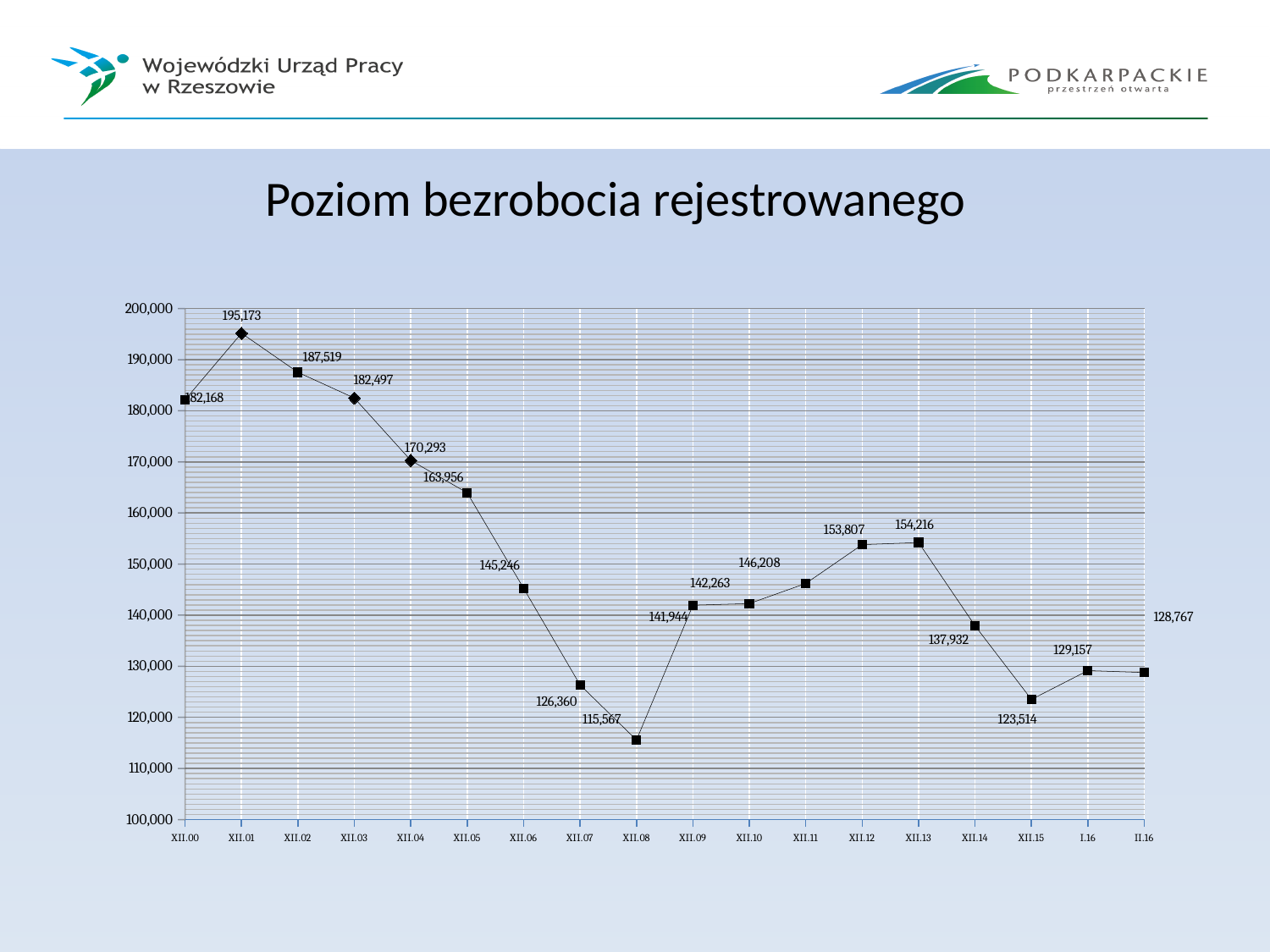
What is the difference between the values for XII.01 and XII.00? 13,005 What type of chart is shown on the slide? line chart Do the values rise or fall from XII.01 to XII.08? fall What is the difference between the values for XII.09 and XII.08? 26,377 What is the value for II.16? 128,767 How many data points are plotted on the chart? 18 Which period has the lowest value? XII.08 What is the value for XII.08? 115,567 What is the title of the chart? Poziom bezrobocia rejestrowanego Which is larger, the value for XII.05 or the value for XII.14? XII.05 Which period has the highest value? XII.01 What is the value for XII.01? 195,173